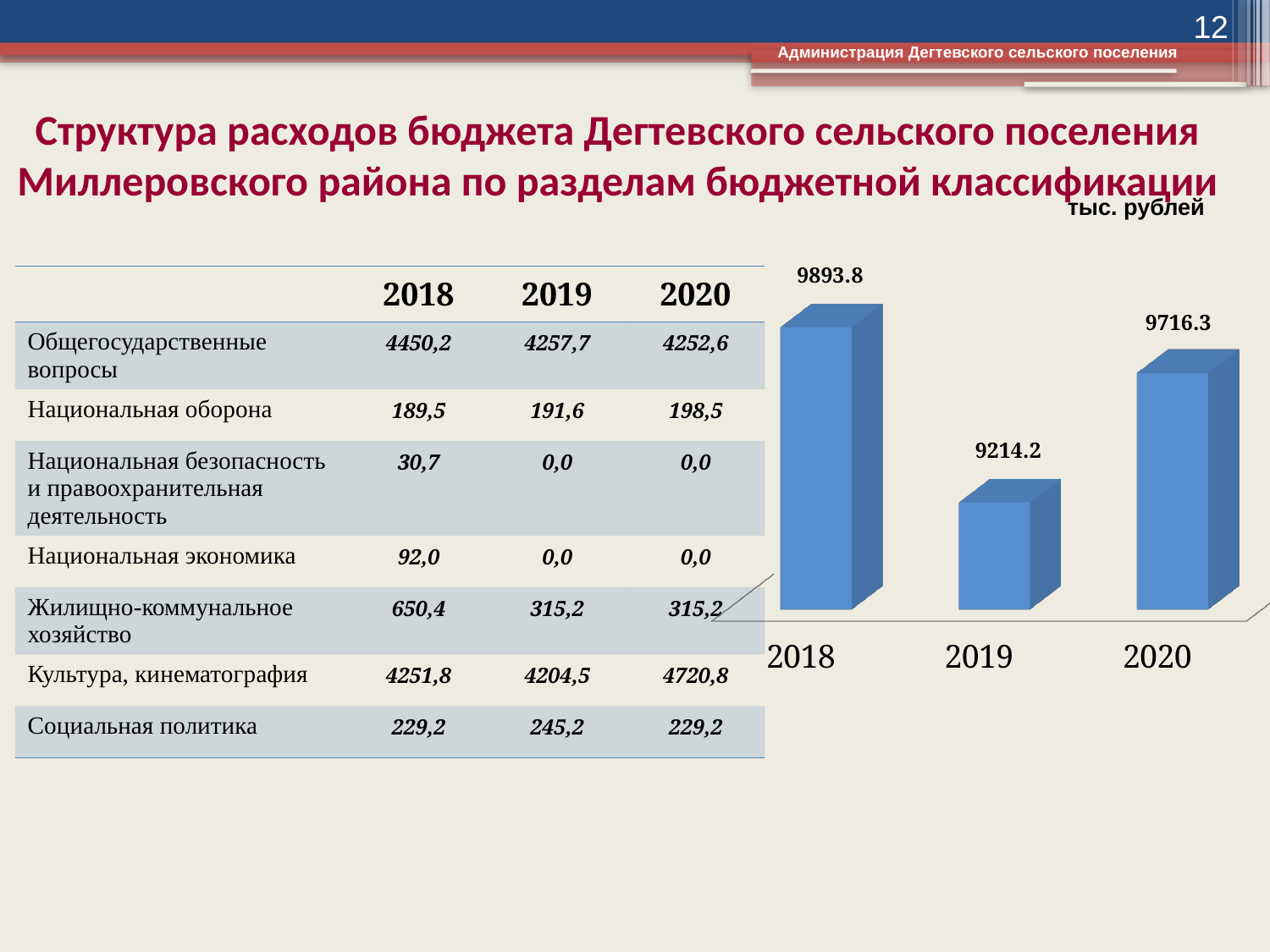
What is the value shown for 2019 in the bar chart? 9214.2 What is the difference between the 2020 and 2019 values in the bar chart? 502.1 What is the difference between the 2018 and 2020 values in the bar chart? 177.5 What is the value shown for 2020 in the bar chart? 9716.3 Which is larger in the bar chart, the value for 2020 or the value for 2019? 2020 Which year has the highest value in the bar chart? 2018 What is the value shown for 2018 in the bar chart? 9893.8 How many bars are plotted in the chart? 3 What kind of chart is shown on the slide? bar chart In what units are the values on the chart expressed, according to the label above it? тыс. рублей Which year has the lowest value in the bar chart? 2019 What is the difference between the 2018 and 2019 values in the bar chart? 679.6